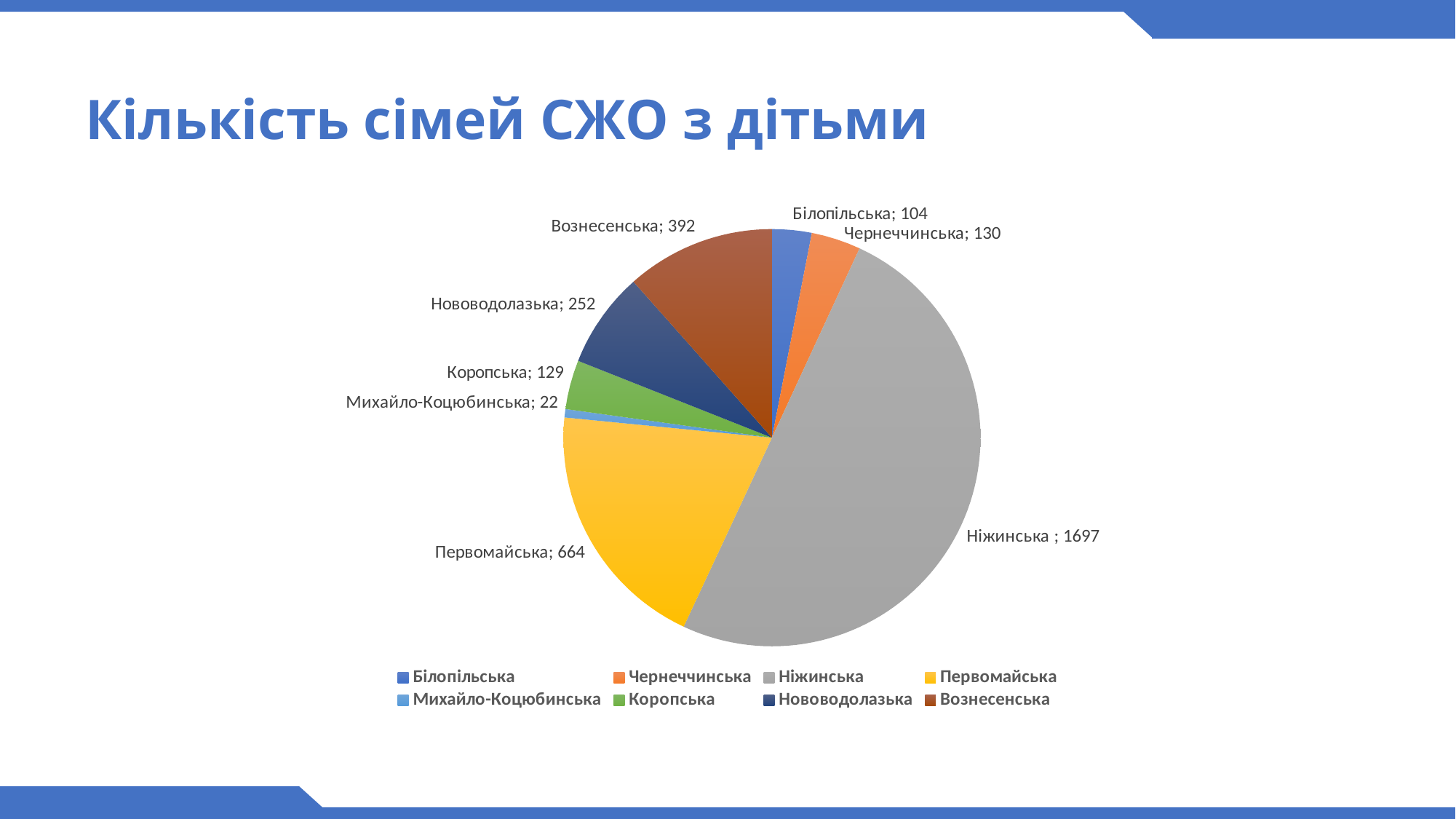
How many categories does the pie chart have? 8 What is the value for Первомайська? 664 What type of chart is shown on the slide? pie chart Which category has the largest slice? Ніжинська Which category has the smallest slice? Михайло-Коцюбинська What is the value for Михайло-Коцюбинська? 22 What is the title of the slide? Кількість сімей СЖО з дітьми Which is larger, the value for Нововодолазька or the value for Білопільська? Нововодолазька What is the value for Ніжинська? 1697 What is the value for Вознесенська? 392 What is the difference between the values for Вознесенська and Нововодолазька? 140 What is the difference between the values for Ніжинська and Первомайська? 1033